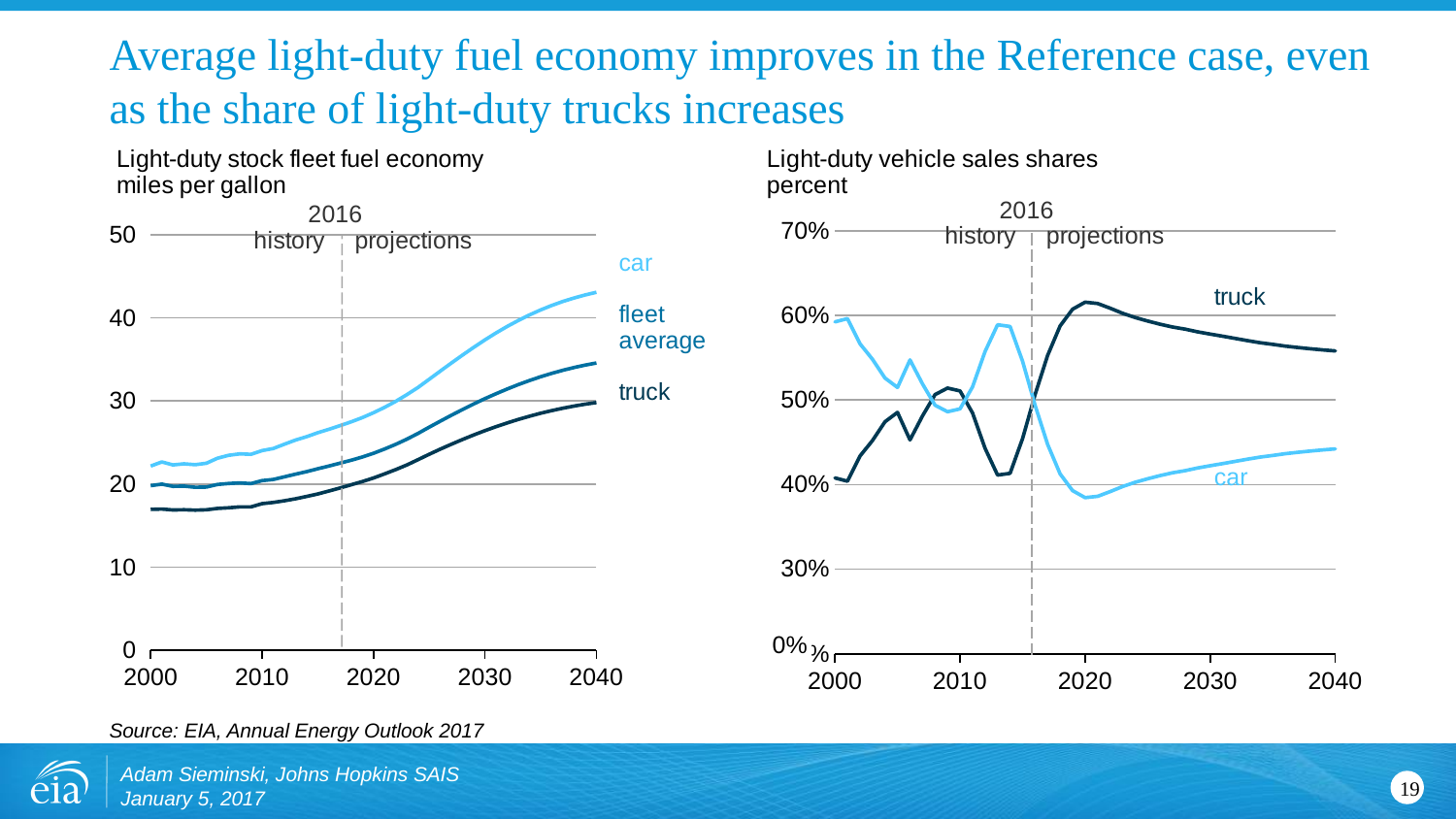
On the 'Light-duty stock fleet fuel economy' chart, is the value for fleet average in 2040 greater or less than 40? less On the 'Light-duty stock fleet fuel economy' chart, does the car series rise or fall from 2000 to 2040? rise On the 'Light-duty stock fleet fuel economy' chart, which series has the highest value in 2040? car On the 'Light-duty vehicle sales shares' chart, which series has the larger value in 2040, truck or car? truck How many series are plotted on the 'Light-duty stock fleet fuel economy' chart on the left? 3 What kind of chart is the 'Light-duty stock fleet fuel economy' chart on the left? line chart On the 'Light-duty vehicle sales shares' chart, what year does the dashed vertical line separating history from projections mark? 2016 On the 'Light-duty stock fleet fuel economy' chart, is the value for car in 2040 greater or less than 40? greater On the 'Light-duty vehicle sales shares' chart, is the value for truck in 2040 greater or less than 50%? greater How many series are plotted on the 'Light-duty vehicle sales shares' chart on the right? 2